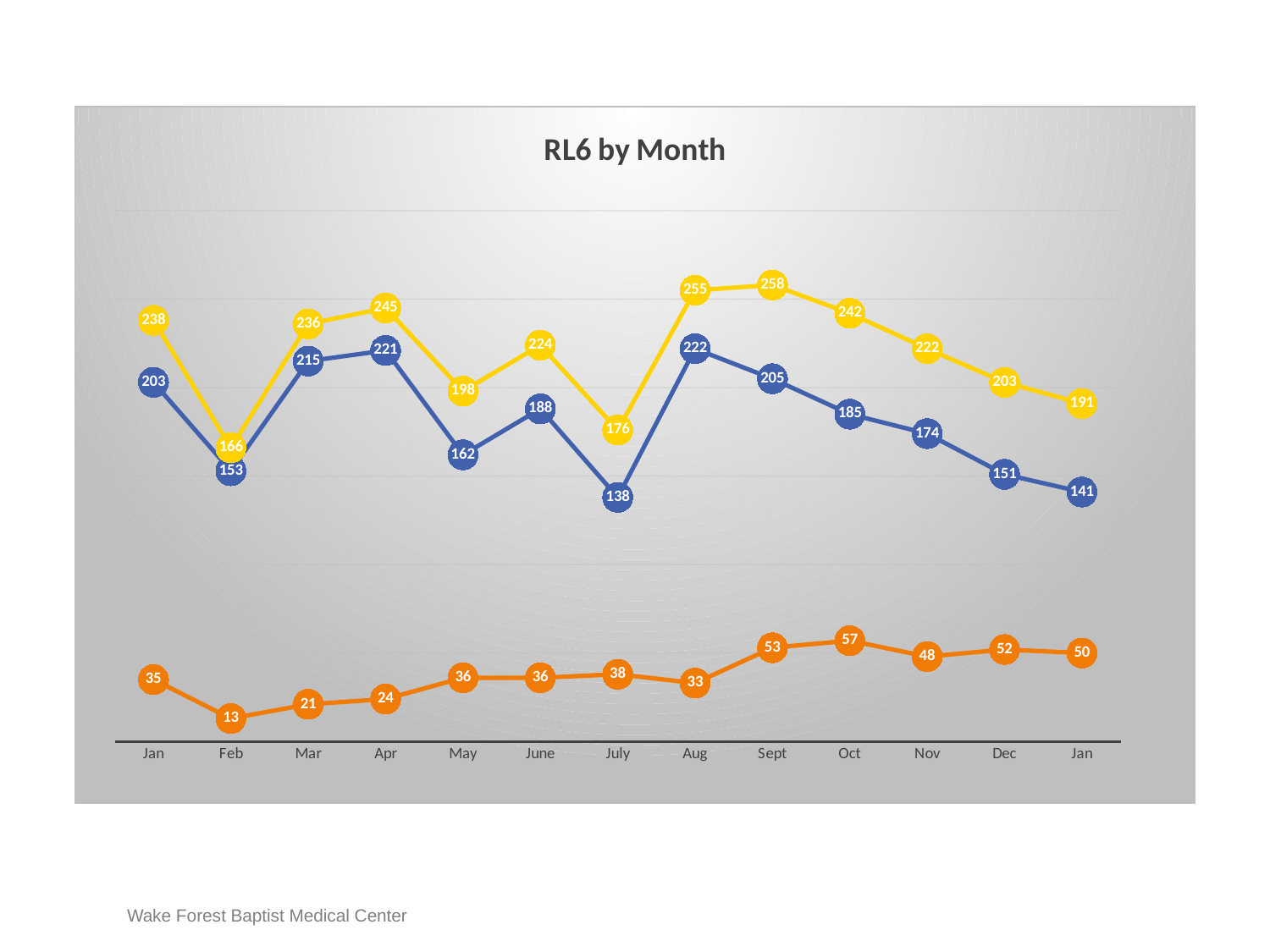
What is the value of the yellow line in Sept? 258 How many lines (series) are plotted on the chart? 3 What type of chart is shown on the slide? line chart In which month does the yellow line reach its highest value? Sept From Sept to the final Jan, does the blue line rise or fall? fall In which month does the blue line reach its lowest value? July Which is larger in Oct: the value of the blue line or the value of the orange line? the blue line What is the difference between the yellow line and the blue line in Aug? 33 What is the title of the chart? RL6 by Month How many months are shown along the x axis of the chart? 13 What is the value of the orange line in Feb? 13 What is the value of the blue line in July? 138